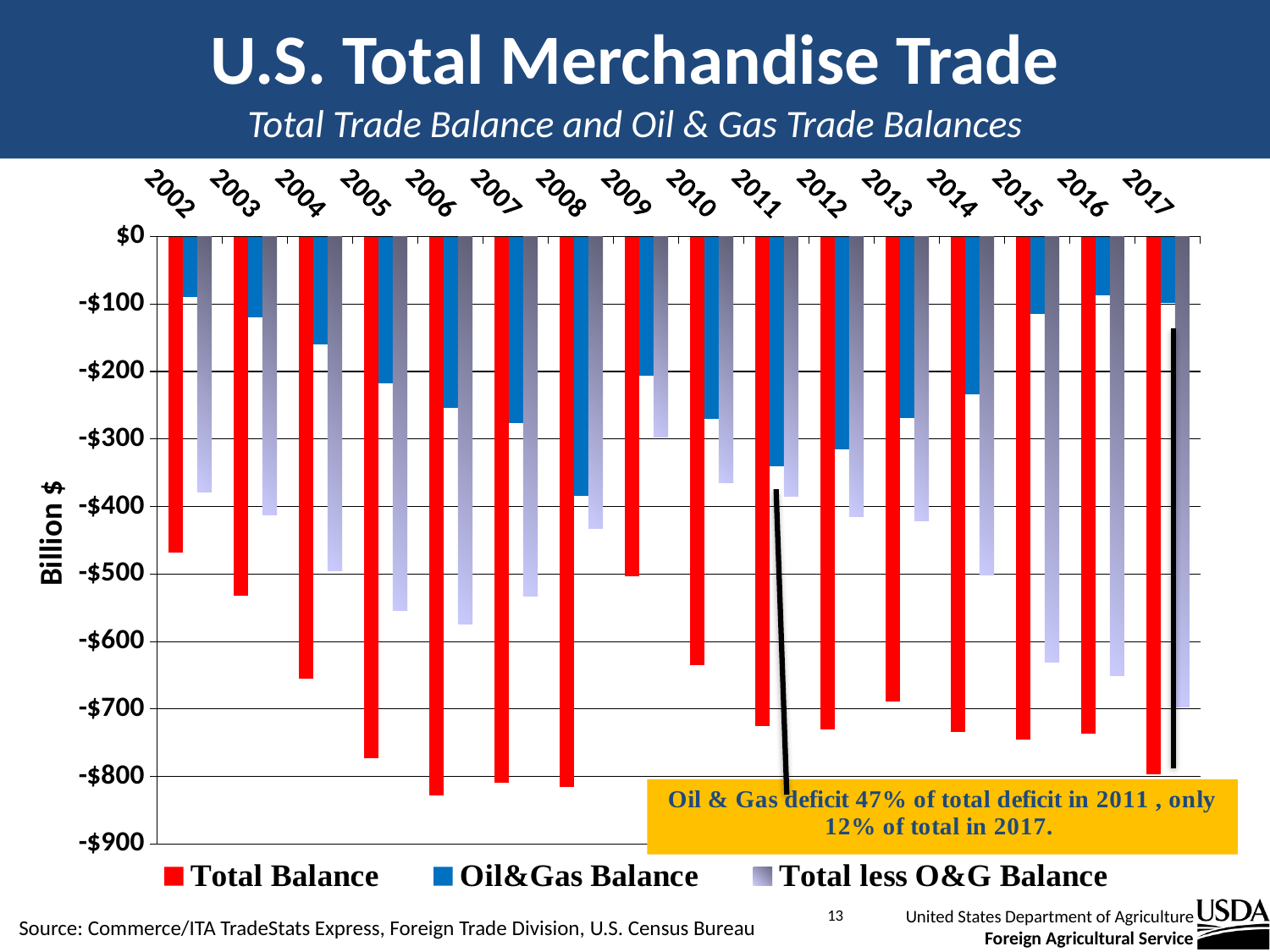
How many years are shown on the x axis of the chart? 16 How many series does the chart's legend list? 3 What kind of chart is shown on the slide? bar chart Which is larger (closer to zero), the Oil&Gas Balance for 2011 or for 2017? 2017 Is the Total less O&G Balance value for 2017 greater or less than -$600? less Is the Oil&Gas Balance value for 2017 greater or less than -$200? greater In which year is the Total less O&G Balance bar the lowest (most negative)? 2017 What are the three series listed in the chart's legend? Total Balance, Oil&Gas Balance, Total less O&G Balance Is the Total Balance value for 2006 greater or less than -$800? less What is the label on the chart's vertical axis? Billion $ From 2011 to 2017, does the Oil&Gas Balance rise (move toward zero) or fall (become more negative)? rise